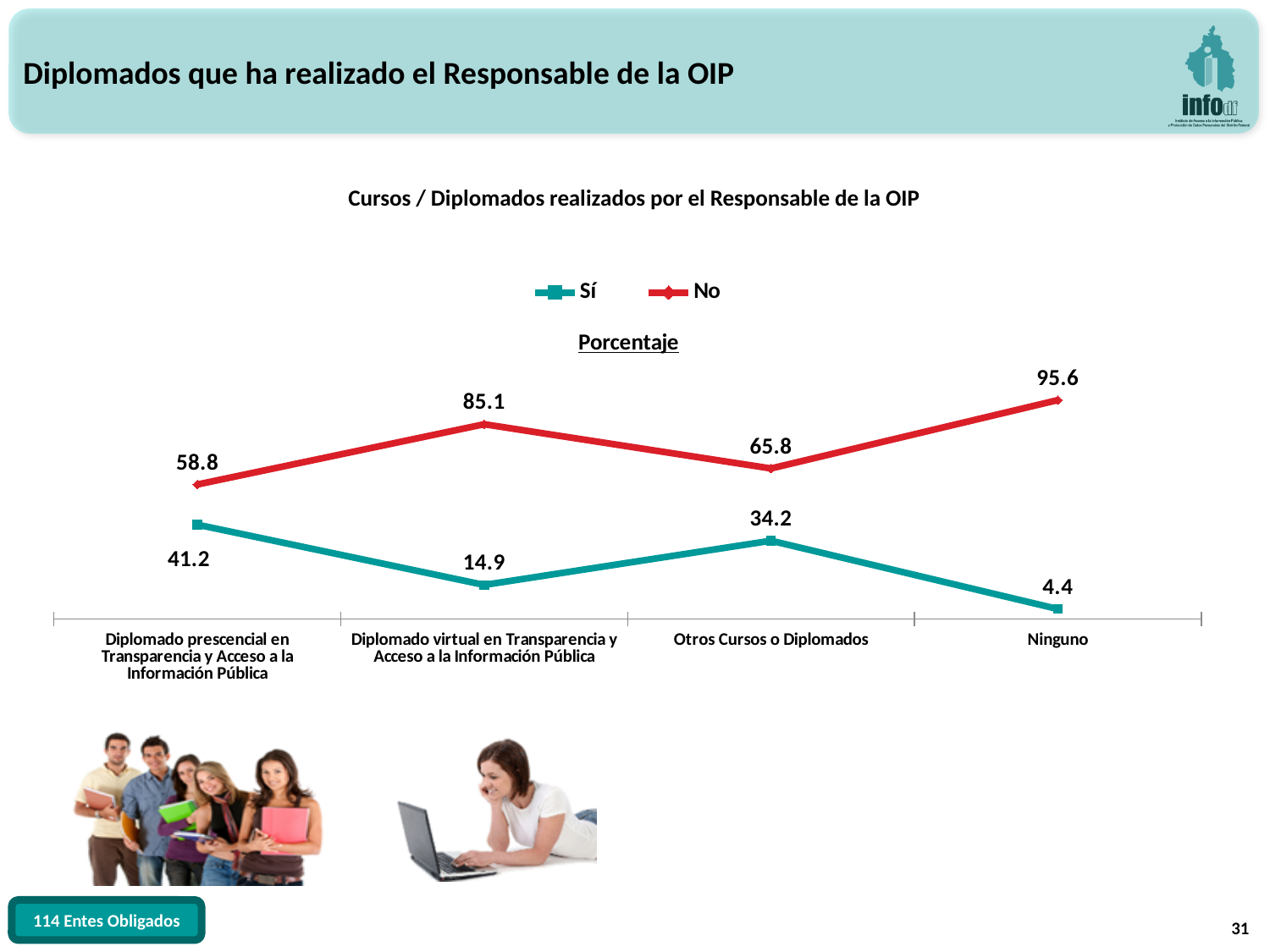
What is the 'No' value for 'Ninguno'? 95.6 What is the 'Sí' value for 'Otros Cursos o Diplomados'? 34.2 What is the 'Sí' value for 'Diplomado virtual en Transparencia y Acceso a la Información Pública'? 14.9 Which category has the lowest 'No' value? Diplomado prescencial en Transparencia y Acceso a la Información Pública How many series does the legend list? 2 What is the 'No' value for 'Diplomado prescencial en Transparencia y Acceso a la Información Pública'? 58.8 What is the title of the chart? Porcentaje What kind of chart is shown on the slide? Line chart Which is larger for 'Otros Cursos o Diplomados', the 'Sí' value or the 'No' value? No What is the difference between the 'No' and 'Sí' values for 'Ninguno'? 91.2 Which category has the highest 'Sí' value? Diplomado prescencial en Transparencia y Acceso a la Información Pública How many categories are shown on the x axis? 4